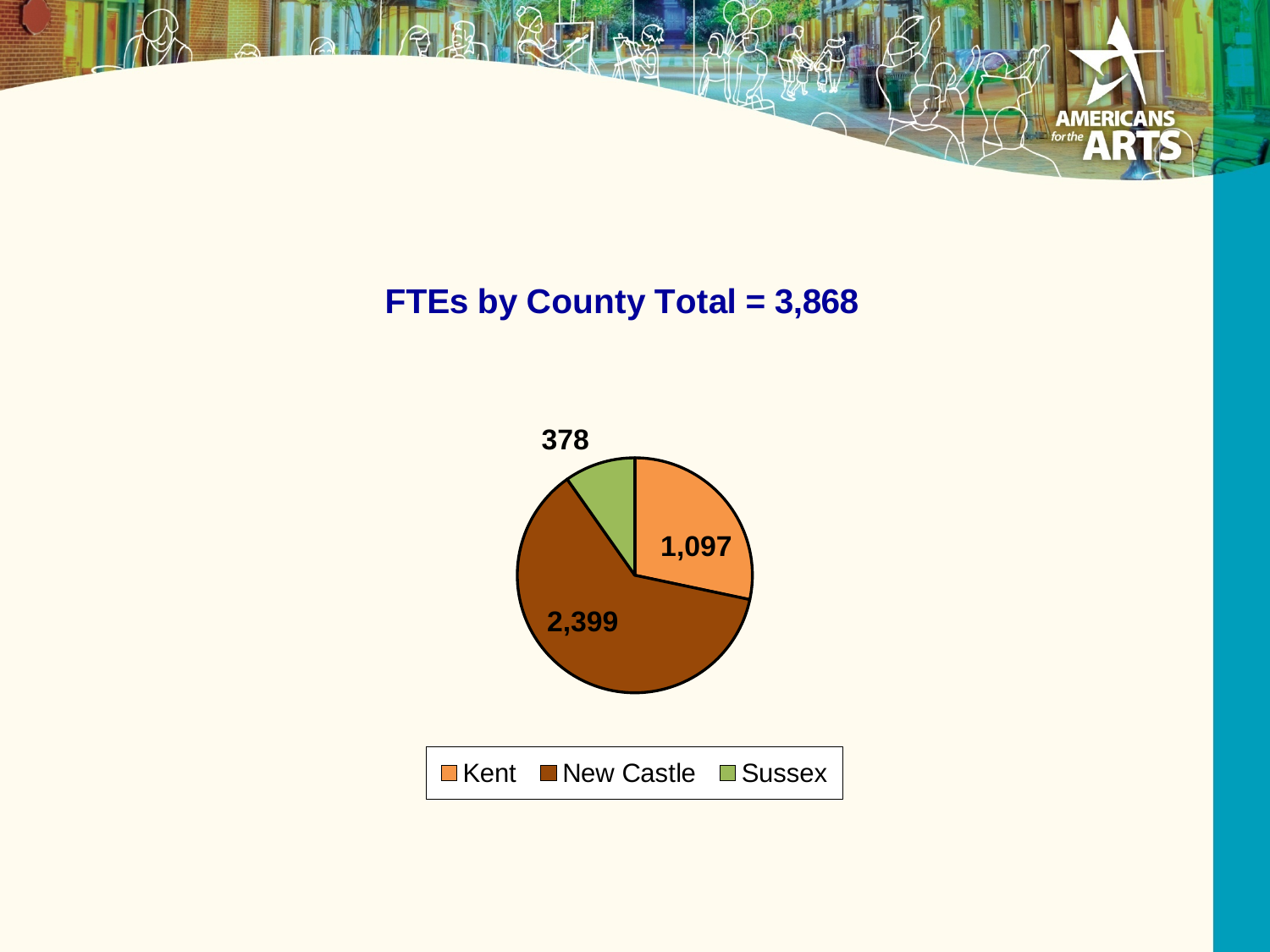
What is the difference between the values for New Castle and Kent? 1,302 Which county has the largest slice of the pie chart? New Castle Which county has the smallest slice of the pie chart? Sussex What is the value for New Castle in the pie chart? 2,399 What is the value for Sussex in the pie chart? 378 What is the difference between the values for New Castle and Sussex? 2,021 How many counties are shown in the pie chart? 3 What total is stated in the chart title? 3,868 What is the value for Kent in the pie chart? 1,097 What kind of chart is shown on the slide? Pie chart What is the difference between the values for Kent and Sussex? 719 Which is larger, the value for Kent or the value for Sussex? Kent